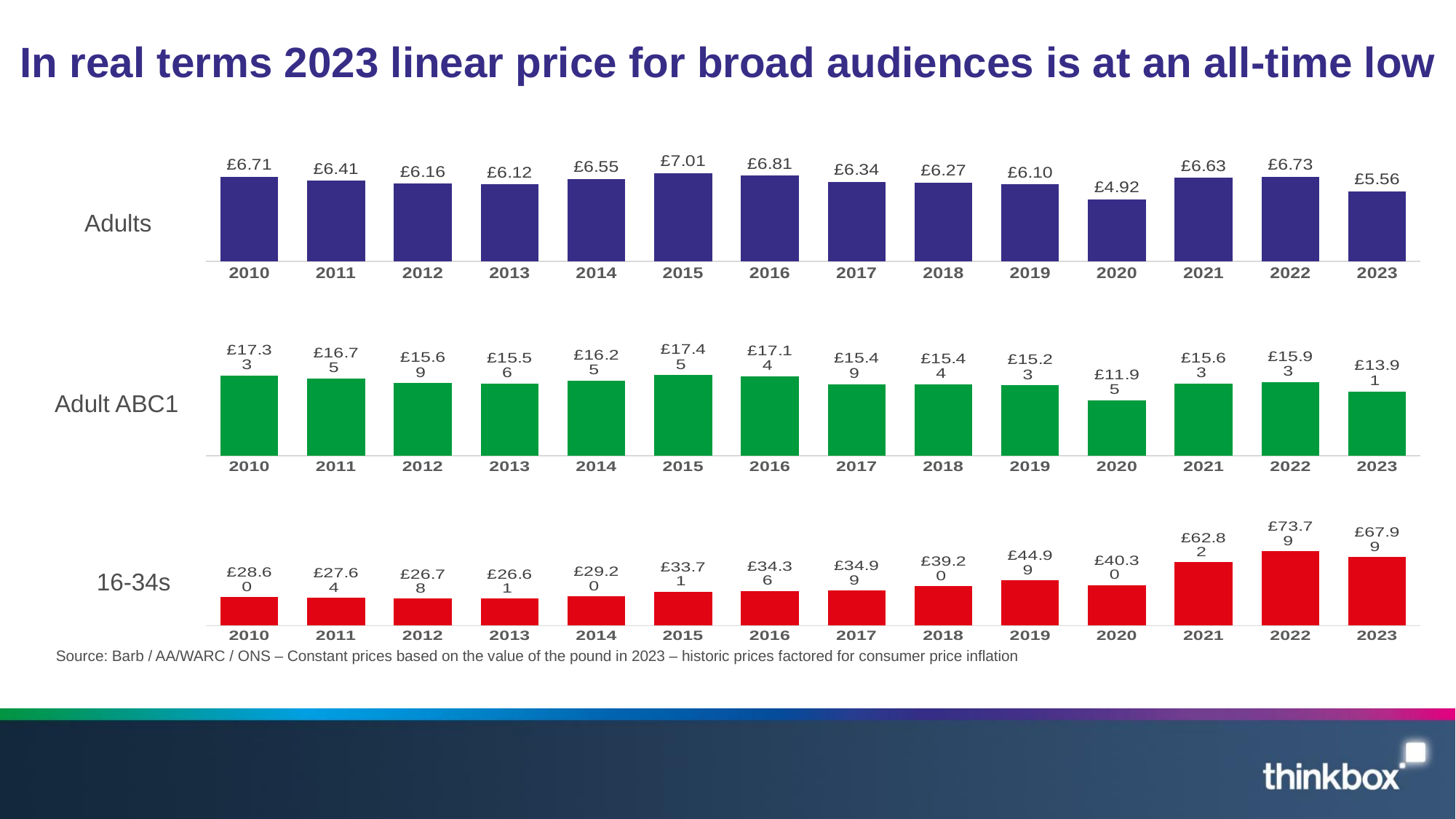
In the 16-34s chart, what is the difference between the 2022 and 2023 values? £5.80 In the Adults chart, what is the value for 2023? £5.56 In the 16-34s chart, what is the value for 2010? £28.60 In the Adults chart, what is the difference between the 2022 and 2023 values? £1.17 In the Adults chart, which year has the highest value? 2015 In the Adult ABC1 chart, which year has the highest value? 2015 How many years are shown on the x axis of the Adults chart? 14 In the Adults chart, which year has the lowest value? 2020 In the 16-34s chart, which is larger, the value for 2020 or the value for 2021? 2021 What kind of chart is used for the 16-34s data? Bar chart In the Adult ABC1 chart, what is the value for 2020? £11.95 In the 16-34s chart, which year has the highest value? 2022